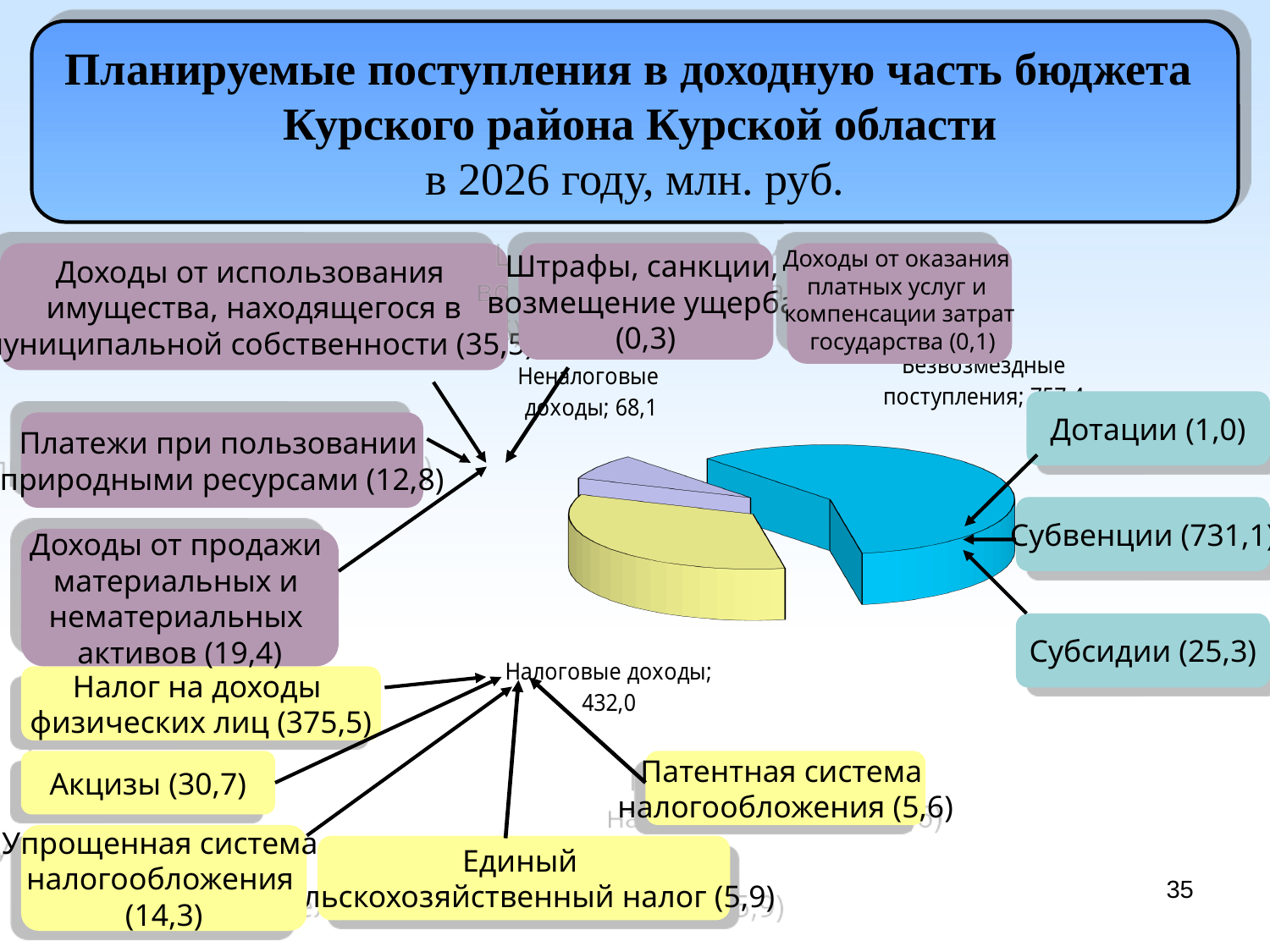
How many slices does the pie chart have? 3 Which is larger in the pie chart, Налоговые доходы or Неналоговые доходы? Налоговые доходы Which slice of the pie chart is the smallest? Неналоговые доходы What kind of chart is shown on the slide? pie chart What colour is the Налоговые доходы slice in the pie chart? yellow What year does the slide title say the planned budget revenues are for? 2026 What is the value shown for Налоговые доходы in the pie chart? 432,0 Which slice of the pie chart is the largest? Безвозмездные поступления Which is larger in the pie chart, Безвозмездные поступления or Налоговые доходы? Безвозмездные поступления What is the difference between the values for Налоговые доходы and Неналоговые доходы in the pie chart? 363,9 What is the value shown for Неналоговые доходы in the pie chart? 68,1